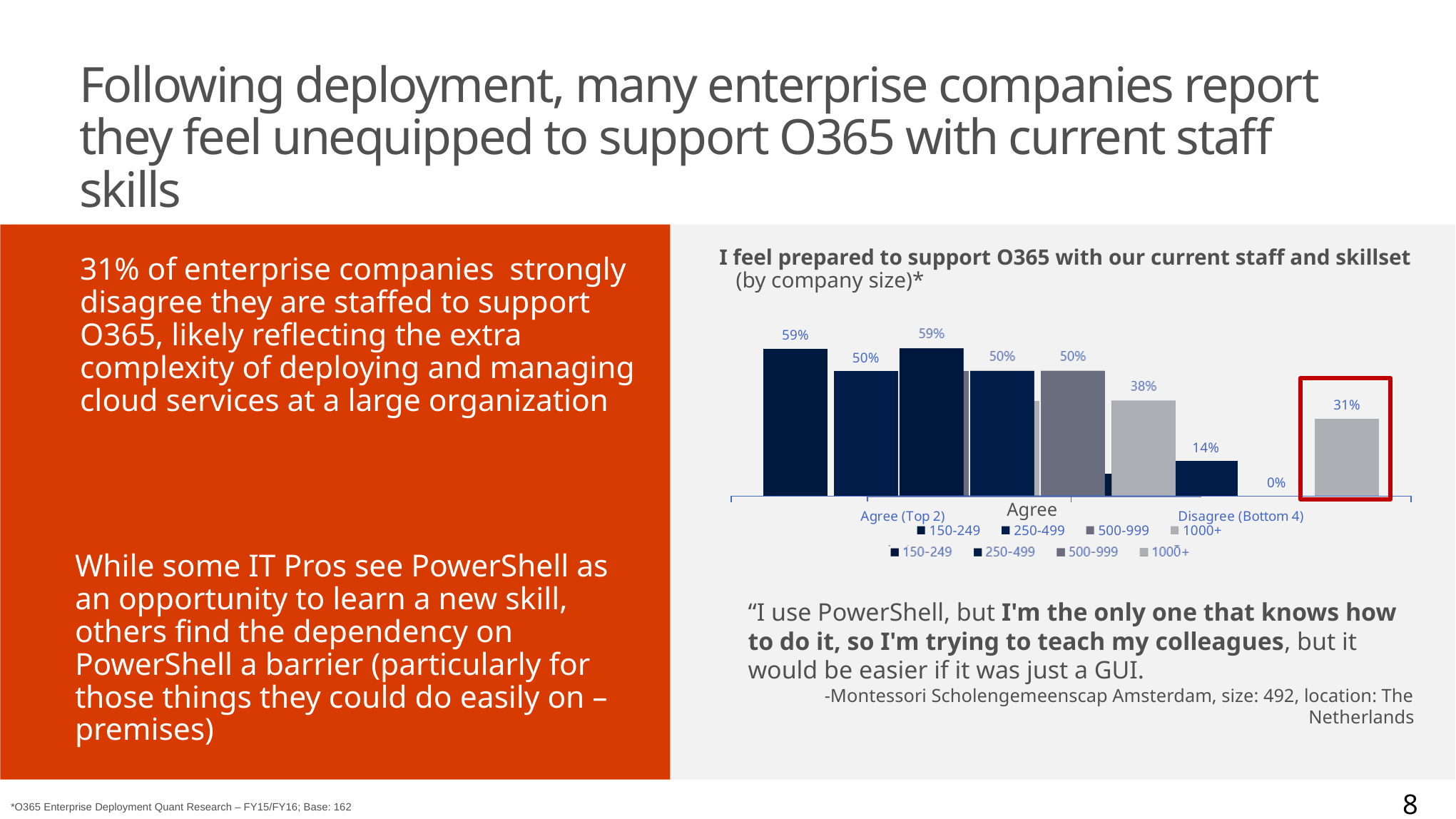
How many series does the chart's legend list? 4 What kind of chart is shown on the slide? bar chart What is the value for the 1000+ company size in the Disagree (Bottom 4) category? 31% Which x-axis category contains the bar outlined in red? Disagree (Bottom 4) What is the title of the chart? I feel prepared to support O365 with our current staff and skillset (by company size)* What is the lowest value labelled on the chart? 0% What value is labelled on the bar outlined in red? 31% What is the highest value labelled on the chart? 59%